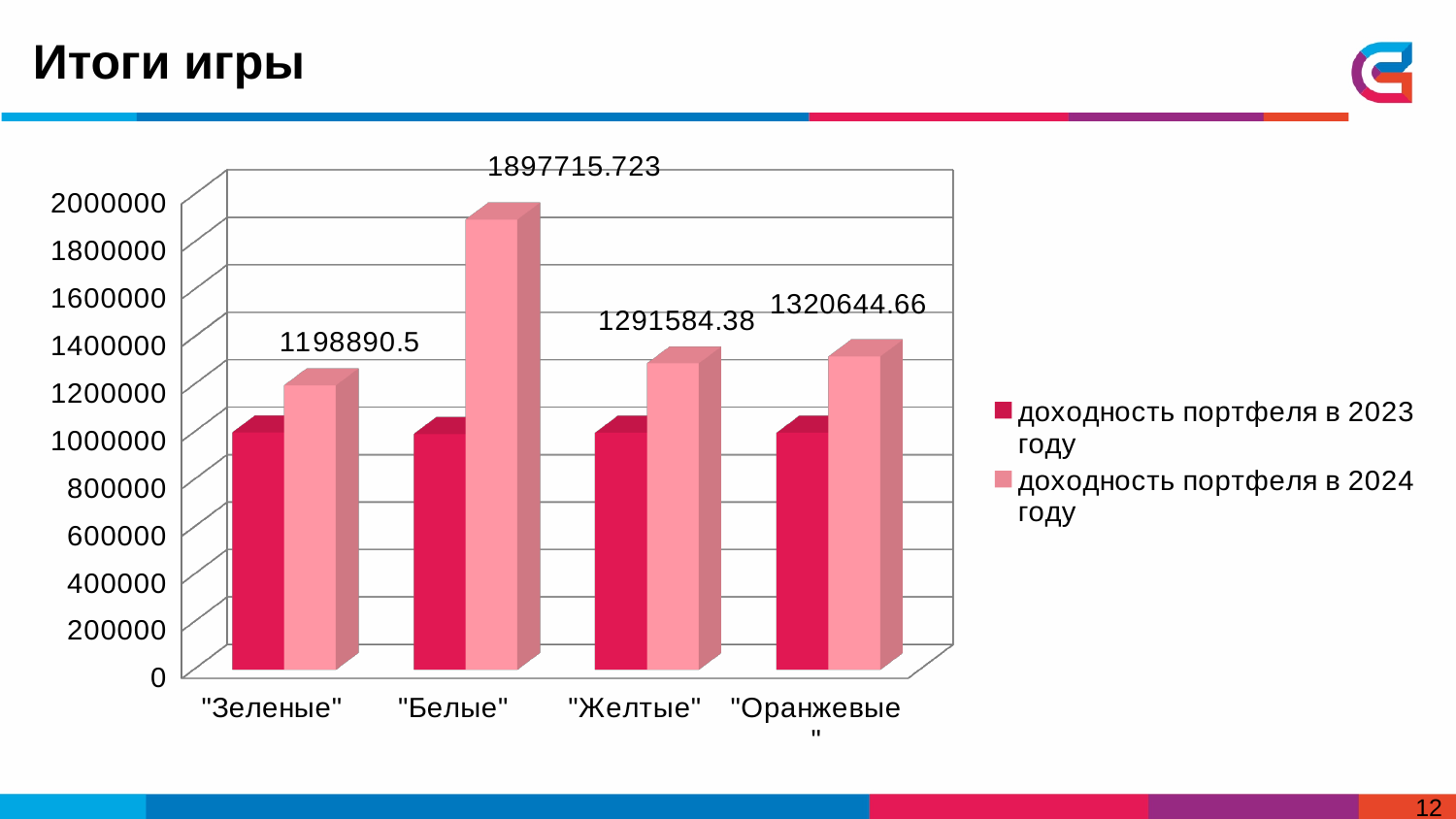
What is the value for "Зеленые" in the series "доходность портфеля в 2024 году"? 1198890.5 Is the value for "Белые" in the series "доходность портфеля в 2023 году" greater or less than 1200000? less Which category has the highest value in the series "доходность портфеля в 2024 году"? "Белые" How many categories are shown on the x axis? 4 What kind of chart is shown on the slide? bar chart How many series does the legend list? 2 What is the value for "Оранжевые" in the series "доходность портфеля в 2024 году"? 1320644.66 What is the value for "Желтые" in the series "доходность портфеля в 2024 году"? 1291584.38 What is the difference between the 2024 values for "Белые" and "Зеленые"? 698825.223 What is the value for "Белые" in the series "доходность портфеля в 2024 году"? 1897715.723 Which category has the lowest value in the series "доходность портфеля в 2024 году"? "Зеленые" Which is larger in the series "доходность портфеля в 2024 году": "Оранжевые" or "Желтые"? "Оранжевые"